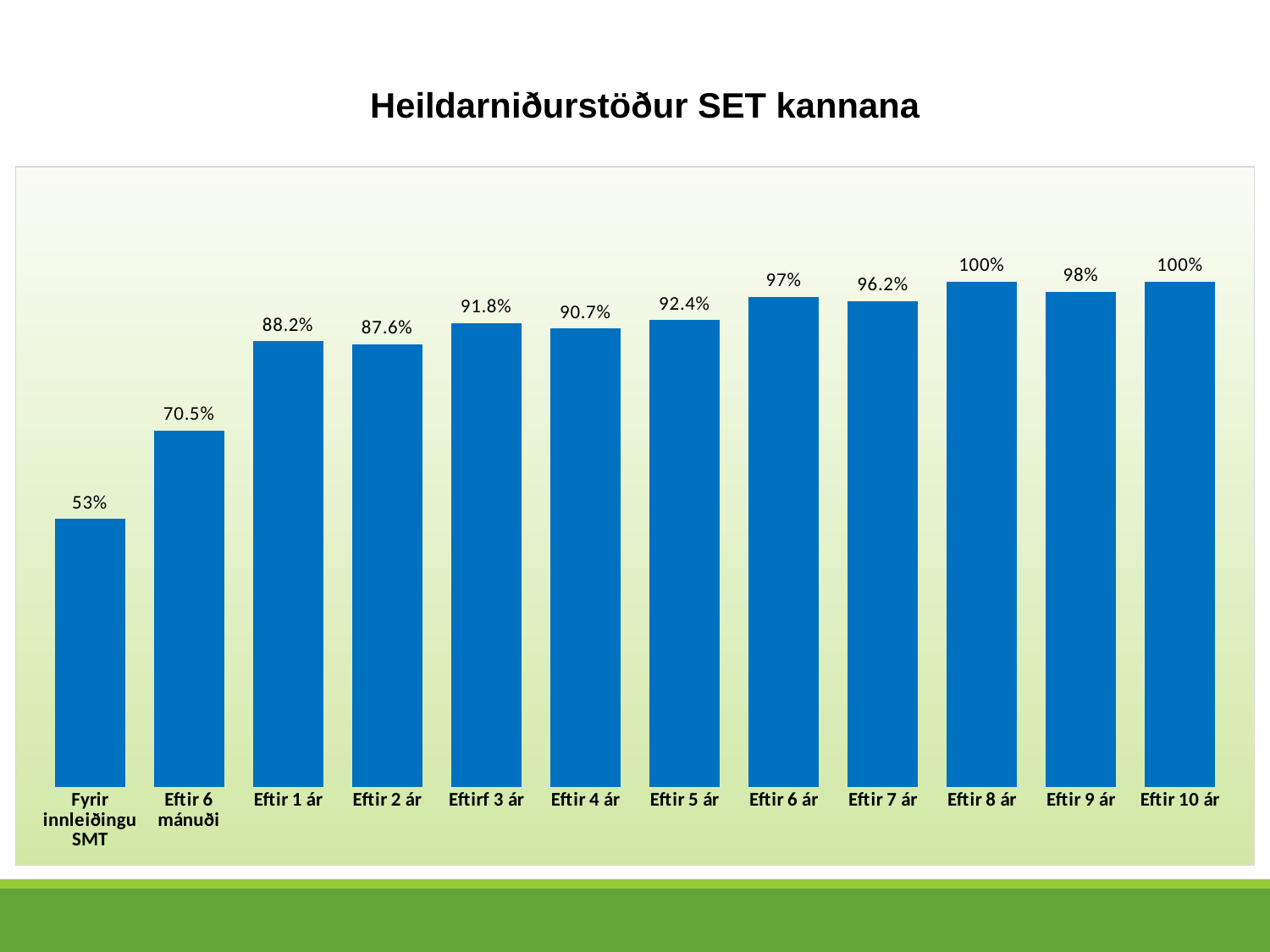
What is the title of the chart? Heildarniðurstöður SET kannana What is the value for "Eftir 5 ár"? 92.4% What is the difference between the values for "Eftir 6 mánuði" and "Fyrir innleiðingu SMT"? 17.5% Which is larger, the value for "Eftir 6 ár" or the value for "Eftir 7 ár"? Eftir 6 ár Which is larger, the value for "Eftir 1 ár" or the value for "Eftir 2 ár"? Eftir 1 ár What is the value for "Fyrir innleiðingu SMT"? 53% Which category has the lowest value? Fyrir innleiðingu SMT What is the value for "Eftir 9 ár"? 98% What kind of chart is shown on the slide? Bar chart What is the value for "Eftir 6 mánuði"? 70.5% What is the difference between the values for "Eftir 10 ár" and "Eftir 9 ár"? 2% How many categories are shown on the x axis? 12